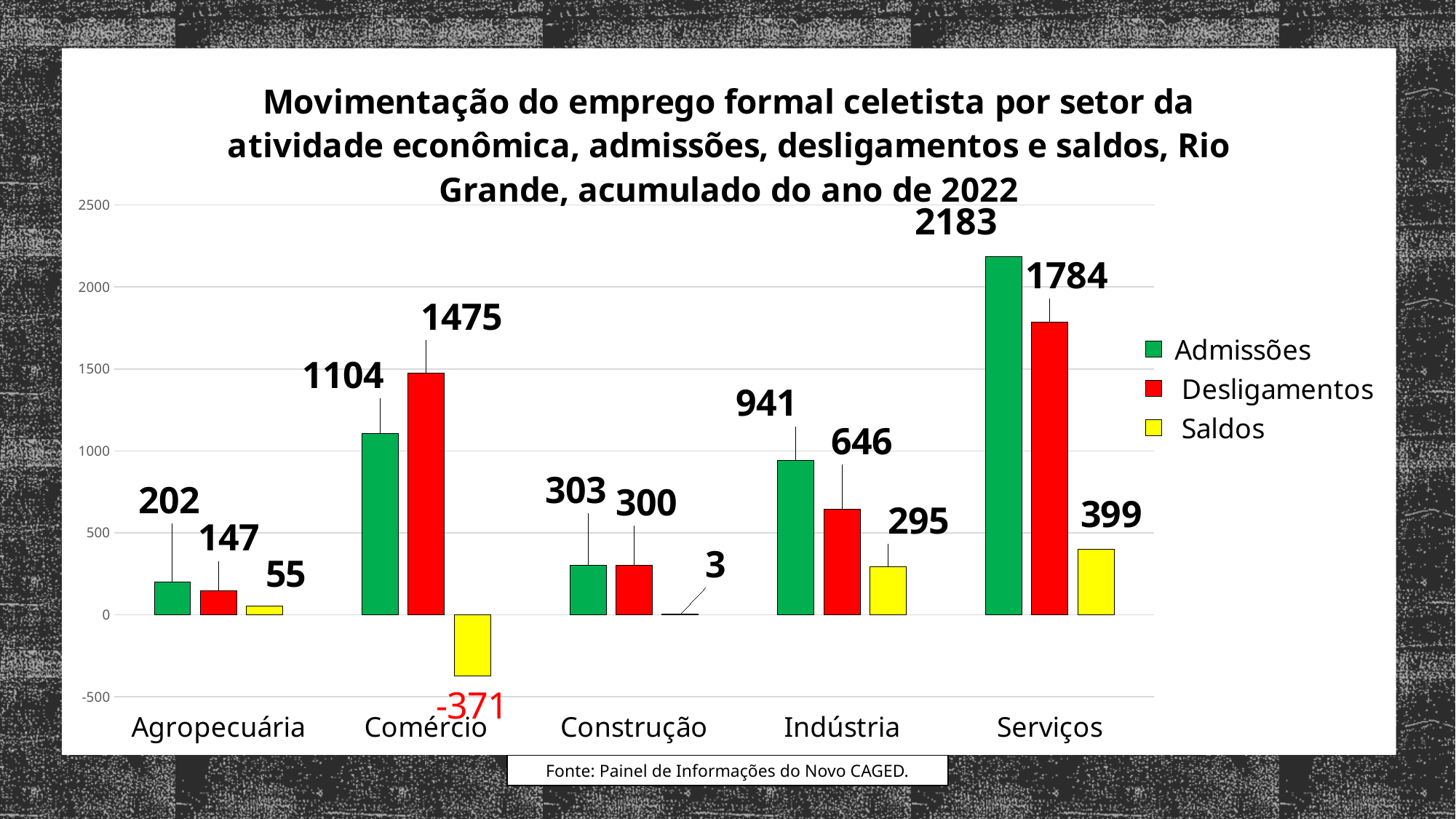
Which sector has the lowest Saldos value? Comércio What is the Desligamentos value for Comércio? 1475 What kind of chart is shown? bar chart Which colour represents Saldos in the legend? yellow What is the difference between Admissões and Desligamentos for Indústria? 295 Which sector has the highest Admissões value? Serviços How many sectors are shown on the x axis? 5 What is the Admissões value for Serviços? 2183 Is the Desligamentos value for Serviços greater or less than 1500? greater How many series does the legend list? 3 Which is larger for Comércio, Admissões or Desligamentos? Desligamentos What is the Saldos value for Construção? 3